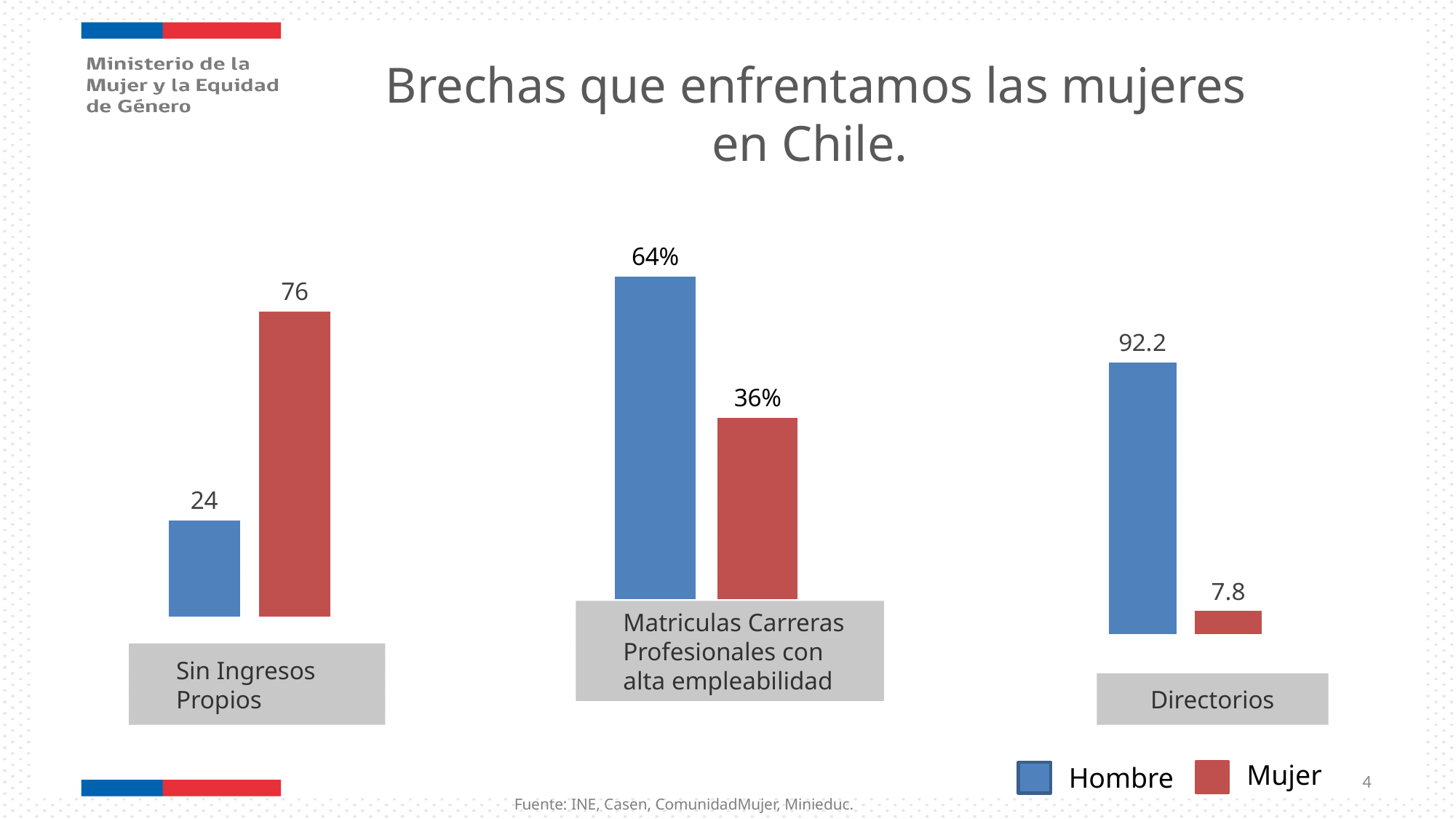
What is the value for Hombre in the Sin Ingresos Propios category? 24 What kind of chart is shown on the slide? Bar chart What is the value for Hombre in the Matriculas Carreras Profesionales con alta empleabilidad category? 64% In which category is the Mujer value highest? Sin Ingresos Propios What is the difference between the Hombre and Mujer values in the Directorios category? 84.4 Which is larger in the Matriculas Carreras Profesionales con alta empleabilidad category, Hombre or Mujer? Hombre What is the value for Mujer in the Directorios category? 7.8 How many series does the legend list? 2 What is the difference between the Mujer and Hombre values in the Sin Ingresos Propios category? 52 In which category is the Hombre value lowest? Sin Ingresos Propios What is the value for Mujer in the Sin Ingresos Propios category? 76 What is the value for Hombre in the Directorios category? 92.2